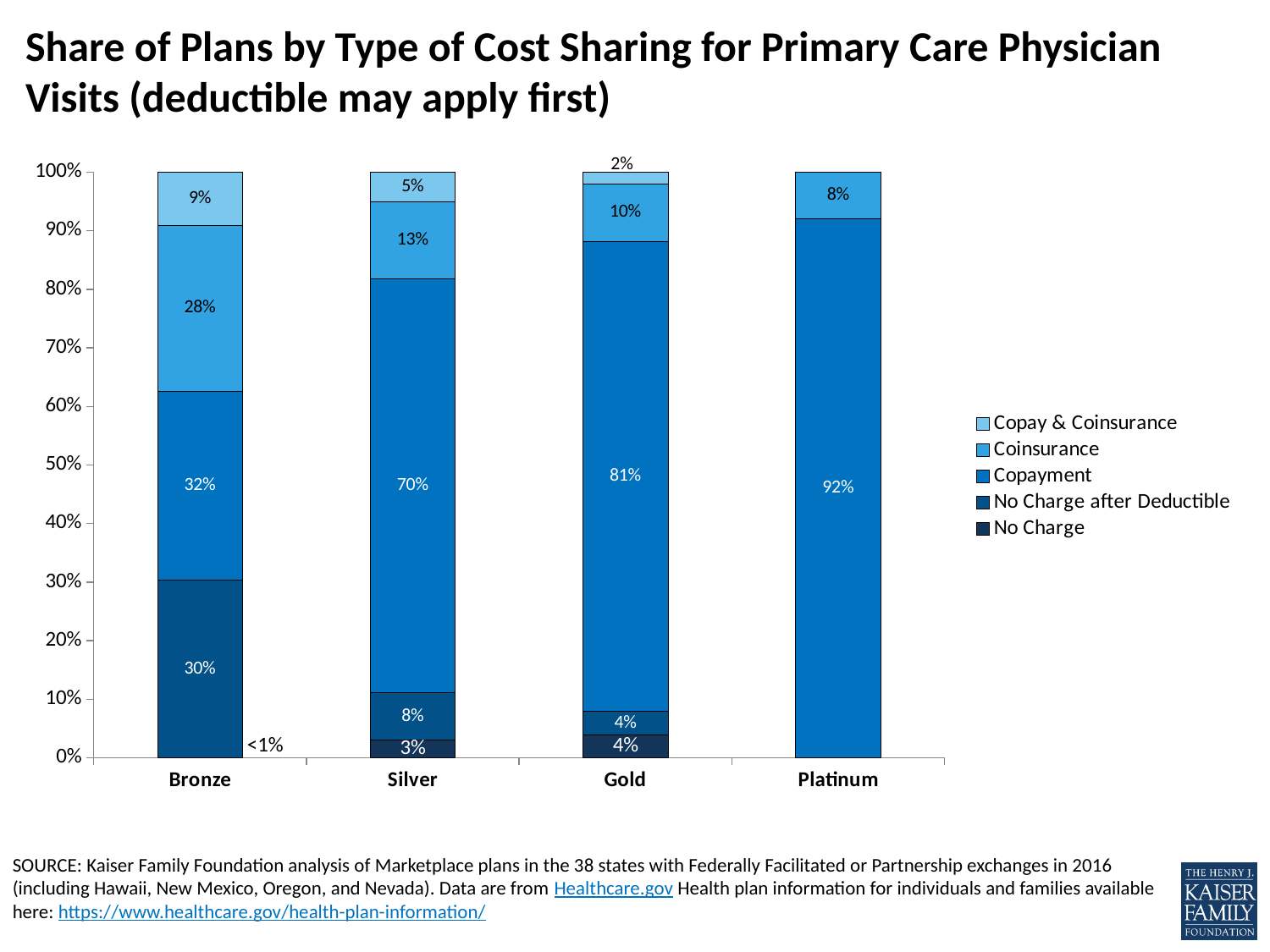
What share of Bronze plans use copay & coinsurance? 9% What share of Bronze plans use a copayment for primary care physician visits? 32% What share of Platinum plans use a copayment? 92% What share of Gold plans have no charge after deductible? 4% Which plan tier has the lowest share of plans using a copayment? Bronze How many plan tiers are shown on the x axis? 4 What kind of chart is shown on the slide? Stacked bar chart Which is larger: the coinsurance share for Bronze or for Gold? Bronze Which plan tier has the highest share of plans using a copayment? Platinum How many series does the legend list? 5 What share of Silver plans use coinsurance? 13% How much larger is the copayment share for Gold than for Silver? 11 percentage points